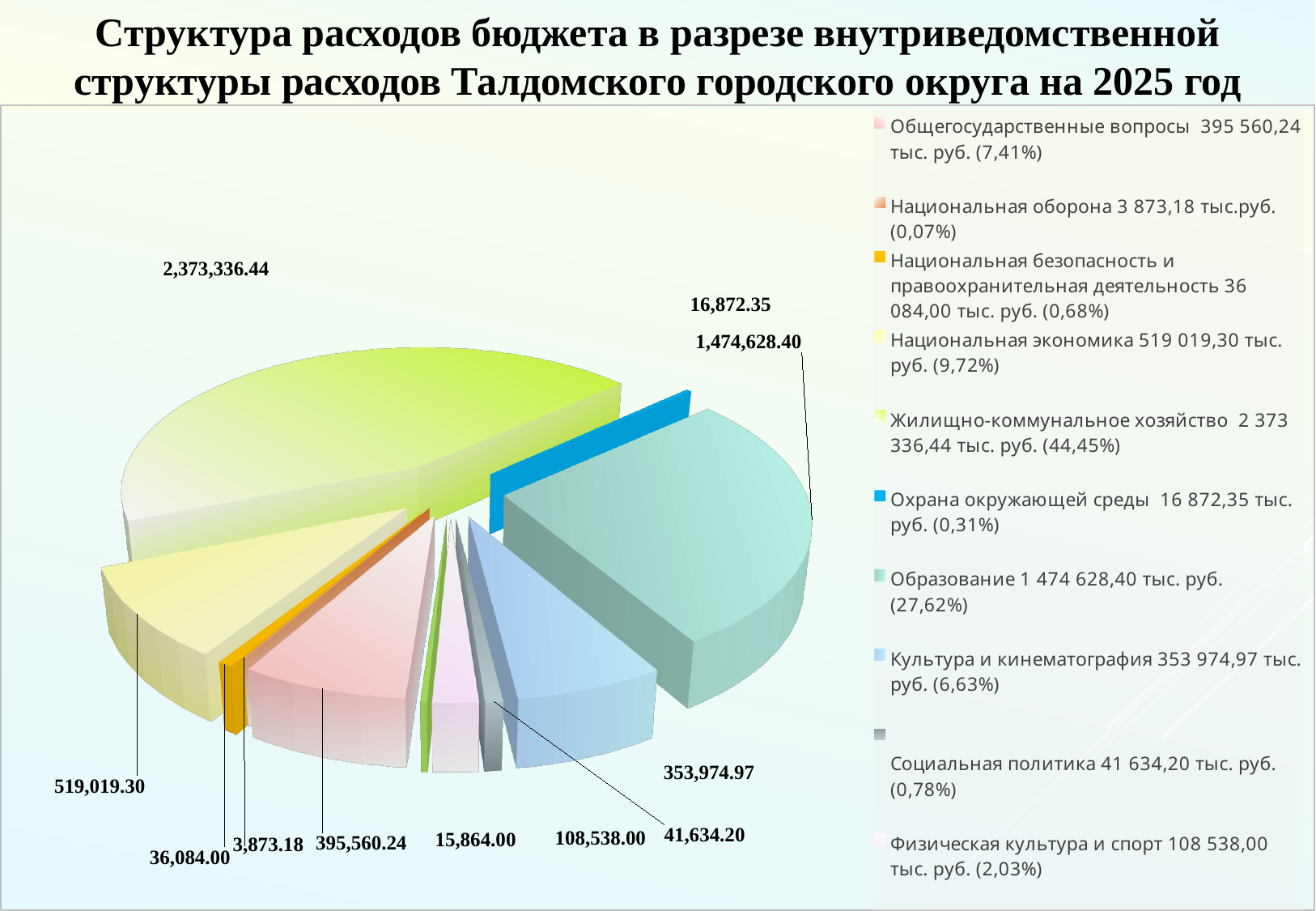
What share of the pie does Жилищно-коммунальное хозяйство represent, according to the legend? 44,45% What is the value shown for Культура и кинематография? 353,974.97 What share of the pie does Образование represent, according to the legend? 27,62% What is the value shown for Национальная экономика? 519,019.30 Which is larger: the value for Национальная экономика or the value for Общегосударственные вопросы? Национальная экономика What is the value shown for Образование? 1,474,628.40 Which category has the smallest slice of the pie? Национальная оборона What is the difference between the values for Жилищно-коммунальное хозяйство and Образование? 898,708.04 What kind of chart is shown on the slide? Pie chart What colour is the slice for Охрана окружающей среды? Blue How many data labels are shown on the pie chart? 11 Which category has the largest slice of the pie? Жилищно-коммунальное хозяйство